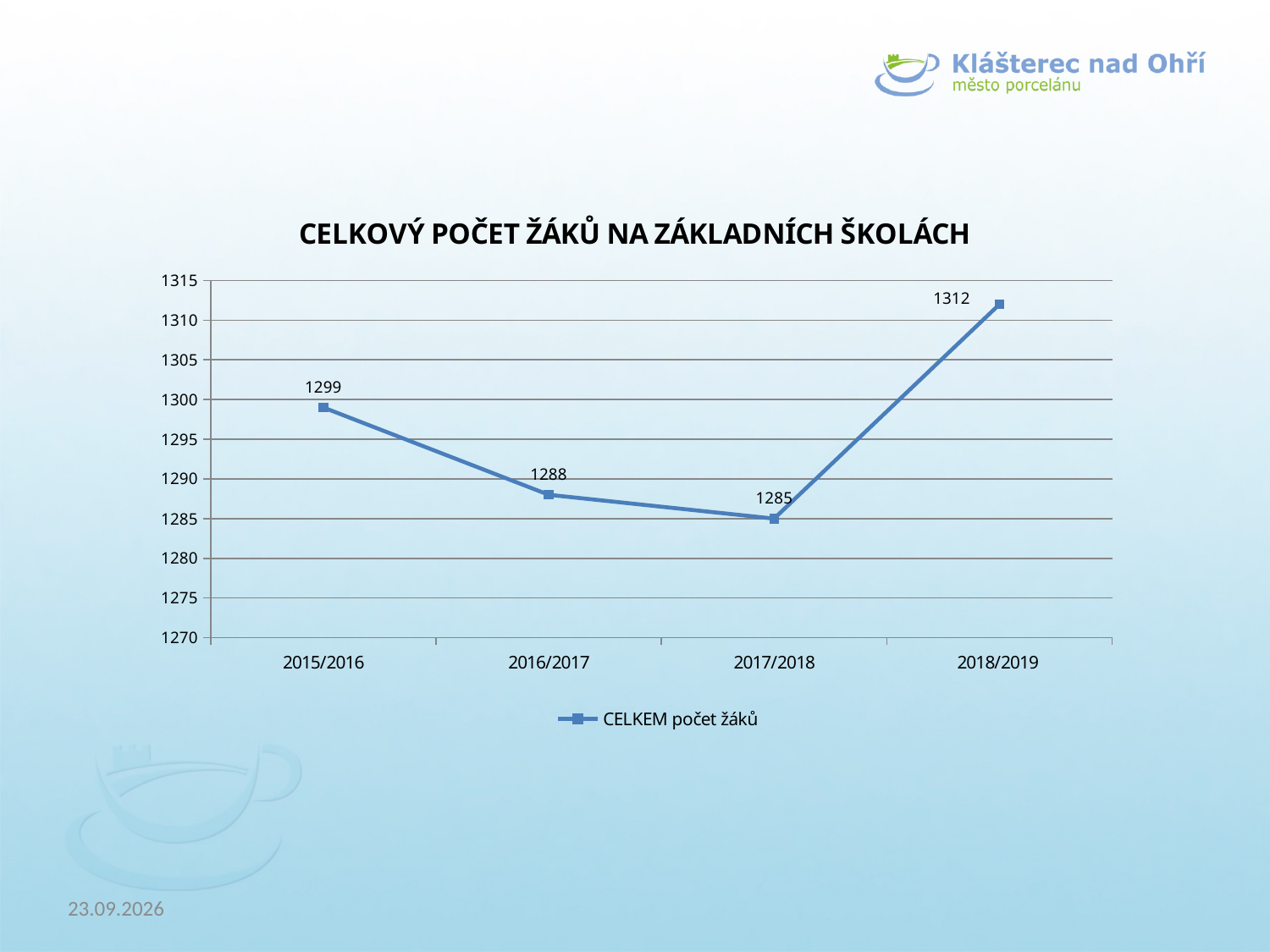
What is the value for 2017/2018? 1285 Is the value for 2018/2019 greater or less than 1305? greater What is the value for 2016/2017? 1288 How many school years are plotted on the x axis? 4 Which is larger, the value for 2015/2016 or the value for 2016/2017? 2015/2016 What kind of chart is shown? line chart Which school year has the highest value? 2018/2019 What is the title of the chart? CELKOVÝ POČET ŽÁKŮ NA ZÁKLADNÍCH ŠKOLÁCH What is the value for 2018/2019? 1312 What is the difference between the values for 2018/2019 and 2017/2018? 27 Which school year has the lowest value? 2017/2018 What is the value for 2015/2016? 1299